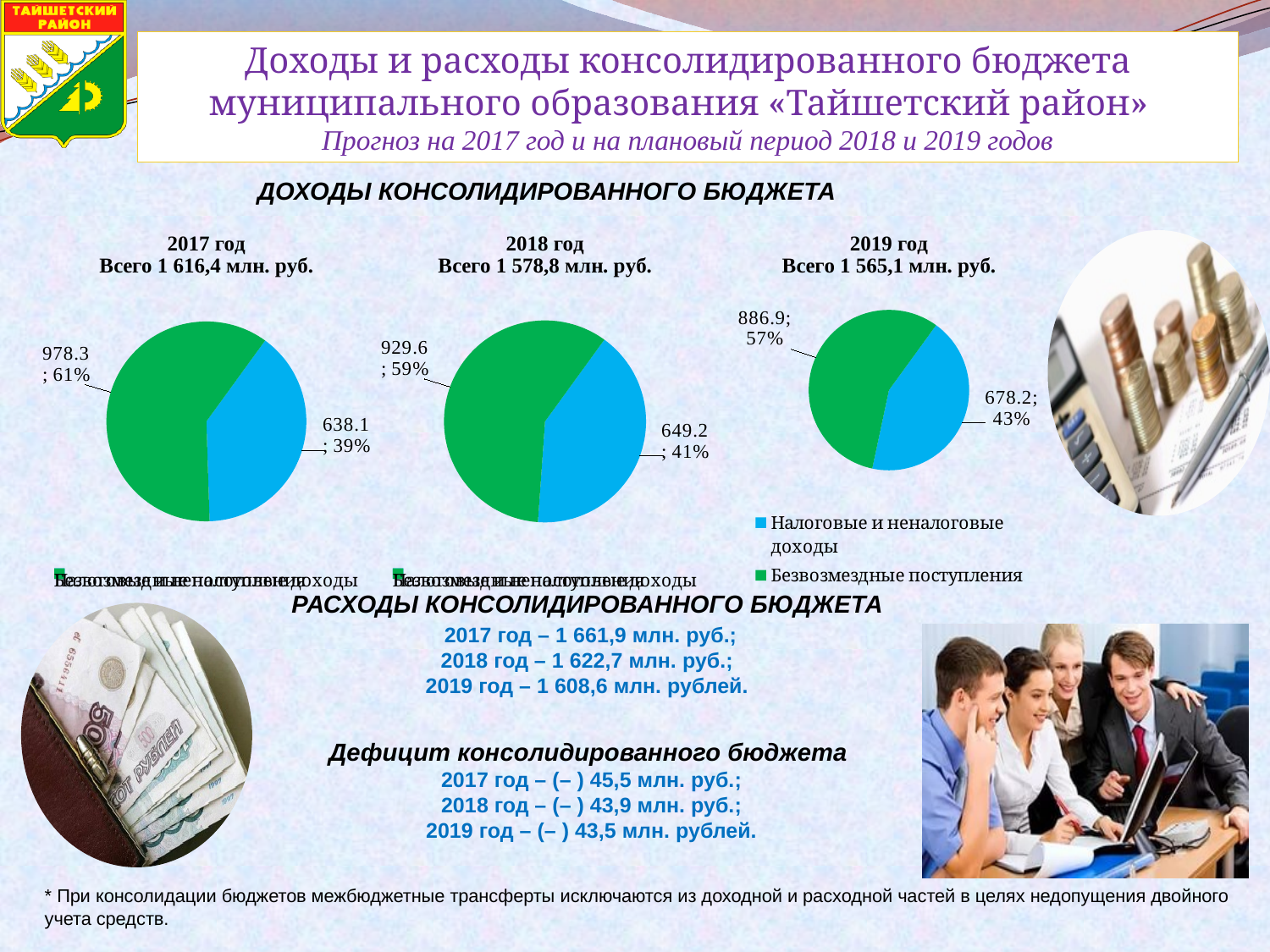
What total is stated above the 2018 pie chart? 1 578,8 млн. руб. In the 2019 pie chart, what share does 'Безвозмездные поступления' take? 57% How many entries does the legend of the 2019 pie chart list? 2 In the 2017 pie chart, what is the value of the green slice? 978.3 In the 2019 pie chart, what is the value of the 'Налоговые и неналоговые доходы' slice? 678.2 In the 2019 pie chart, what is the difference between the 'Безвозмездные поступления' value and the 'Налоговые и неналоговые доходы' value? 208.7 How many slices does each revenue pie chart have? 2 In the 2018 pie chart, what is the value of the blue slice? 649.2 In the 2018 pie chart, which slice is larger, the green one or the blue one? green How many pie charts are shown in the revenues section of the slide? 3 In the 2017 pie chart, what percentage share does the blue slice have? 39% What type of chart is used to show the 2017 consolidated budget revenues? pie chart